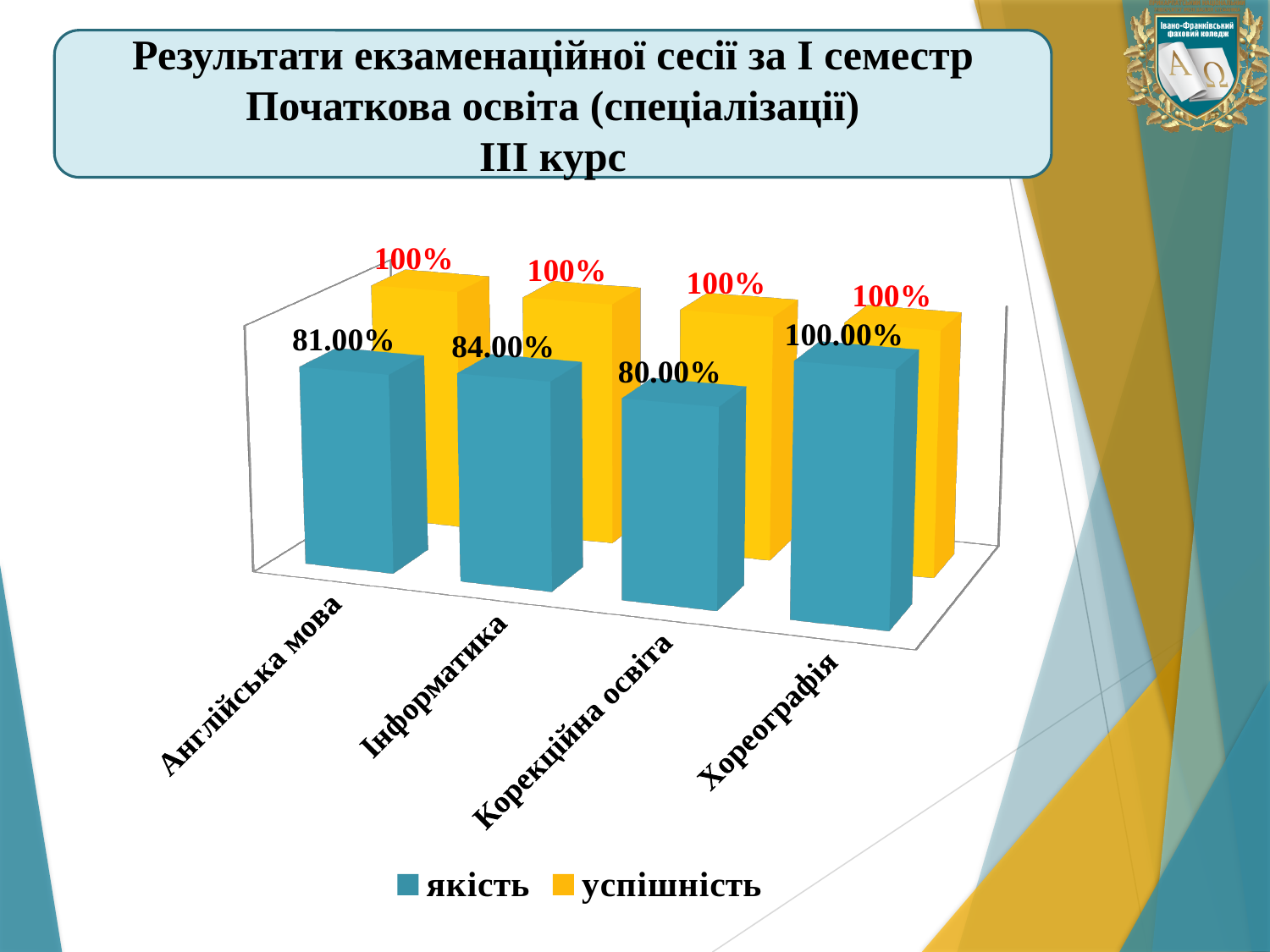
What is the якість value for Інформатика? 84.00% Which series is shown in yellow according to the legend? успішність How many categories are shown on the x axis? 4 Which category has the lowest якість value? Корекційна освіта What is the якість value for Хореографія? 100.00% Which category has the highest якість value? Хореографія How many series does the legend list? 2 What is the difference between the якість values for Інформатика and Англійська мова? 3.00% What is the якість value for Корекційна освіта? 80.00% What kind of chart is shown on the slide? Bar chart Which is larger, the якість value for Англійська мова or for Інформатика? Інформатика What is the успішність value for Англійська мова? 100%